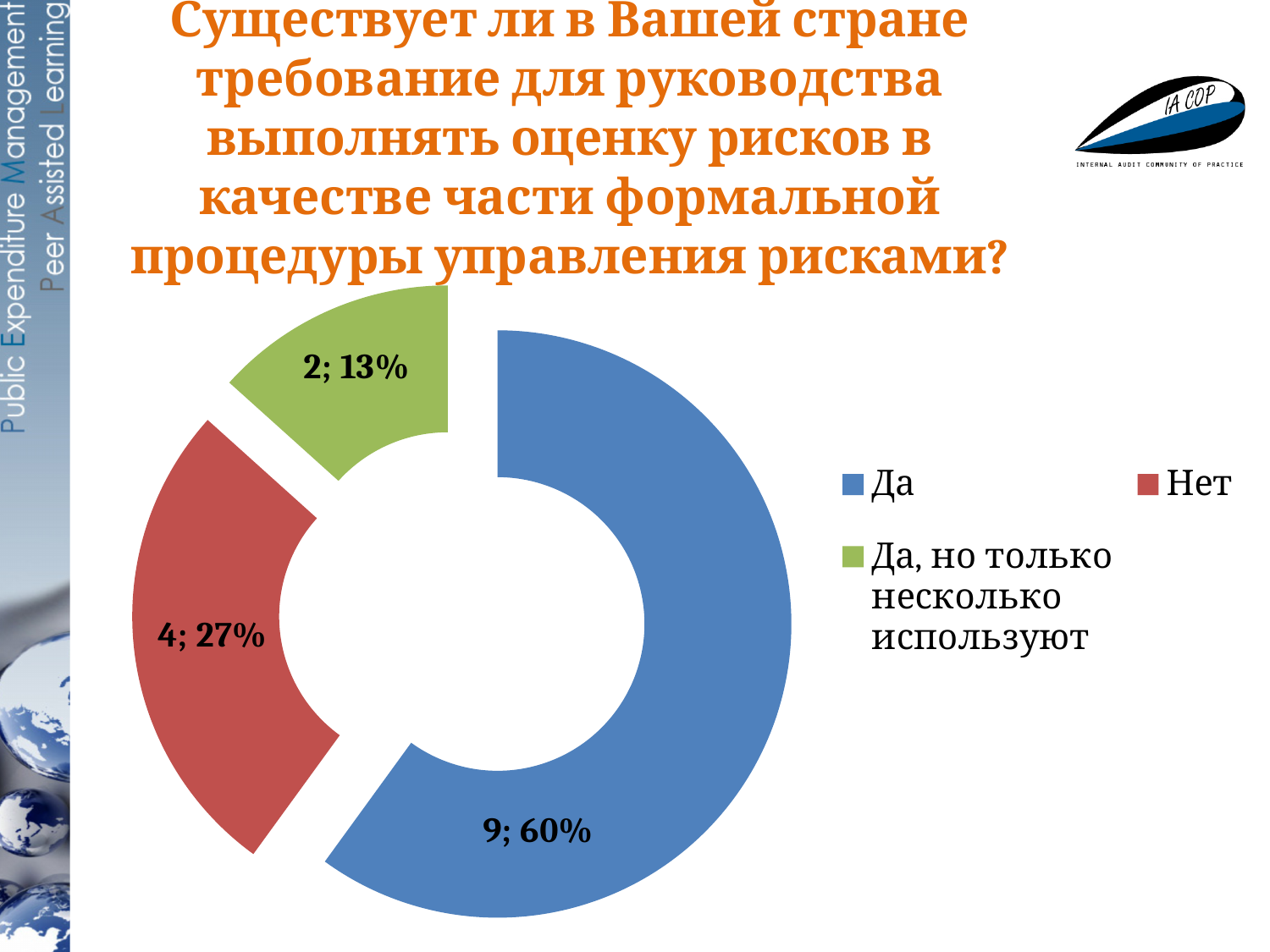
What is the count for the "Да, но только несколько используют" category? 2 Which colour represents the "Нет" category in the legend? Red How many categories does the chart show? 3 What is the difference in count between the "Да" and "Нет" categories? 5 What is the count for the "Нет" category? 4 Which category has the smallest slice? Да, но только несколько используют What kind of chart is shown on the slide? Doughnut (pie) chart What is the count for the "Да" category? 9 What share of the chart does the "Нет" slice represent? 27% What share of the chart does the "Да" slice represent? 60% What share of the chart does the "Да, но только несколько используют" slice represent? 13% Which category has the largest slice? Да